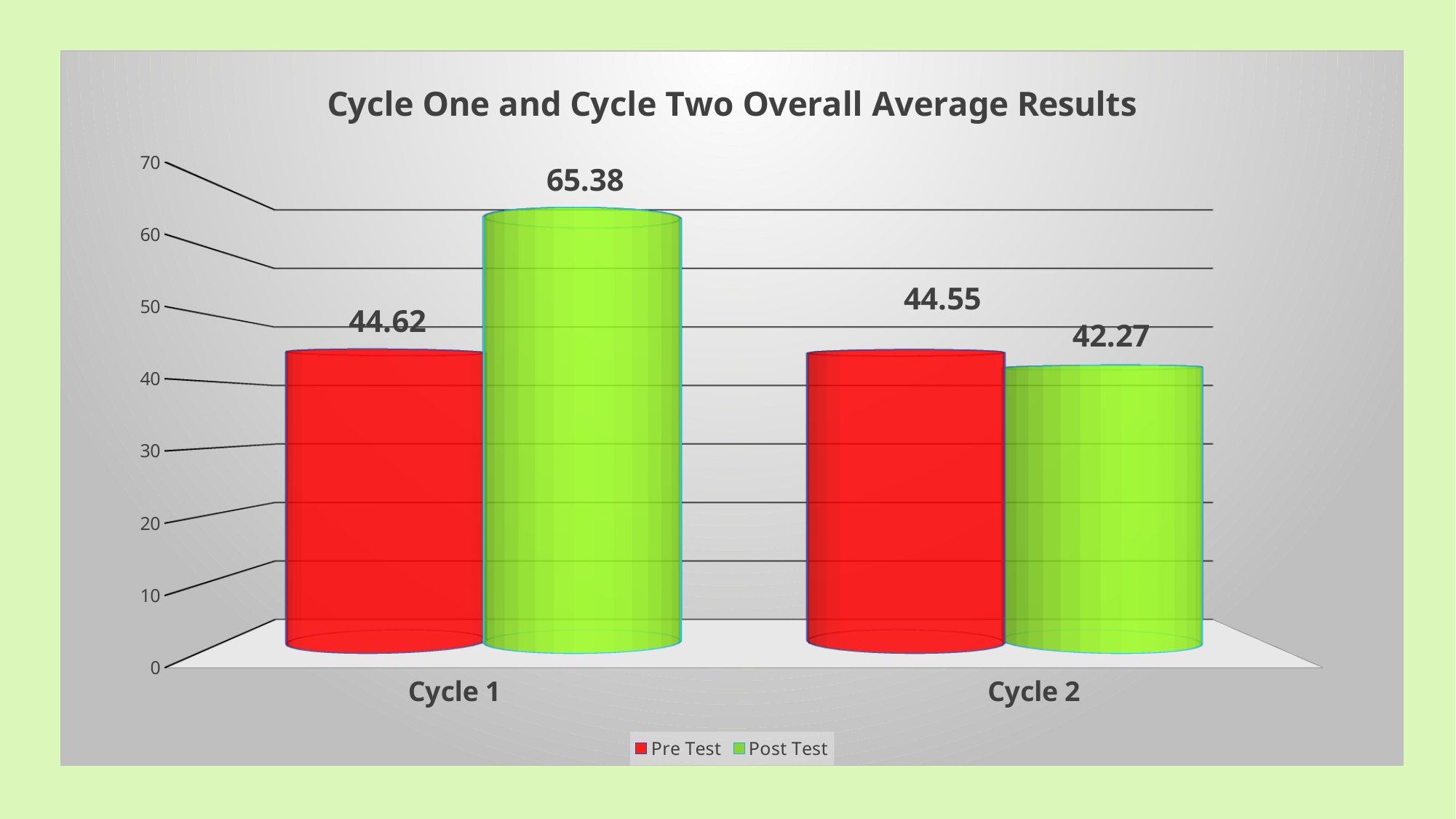
How many series does the legend list? 2 What is the difference between the Post Test and Pre Test values for Cycle 1? 20.76 What is the difference between the Pre Test and Post Test values for Cycle 2? 2.28 What is the title of the chart? Cycle One and Cycle Two Overall Average Results What is the Post Test value for Cycle 1? 65.38 How many categories are shown on the x axis? 2 What is the Post Test value for Cycle 2? 42.27 What is the Pre Test value for Cycle 1? 44.62 Which bar has the highest value on the chart? Post Test, Cycle 1 What is the Pre Test value for Cycle 2? 44.55 Which is larger for Cycle 2, the Pre Test or the Post Test value? Pre Test Which bar has the lowest value on the chart? Post Test, Cycle 2